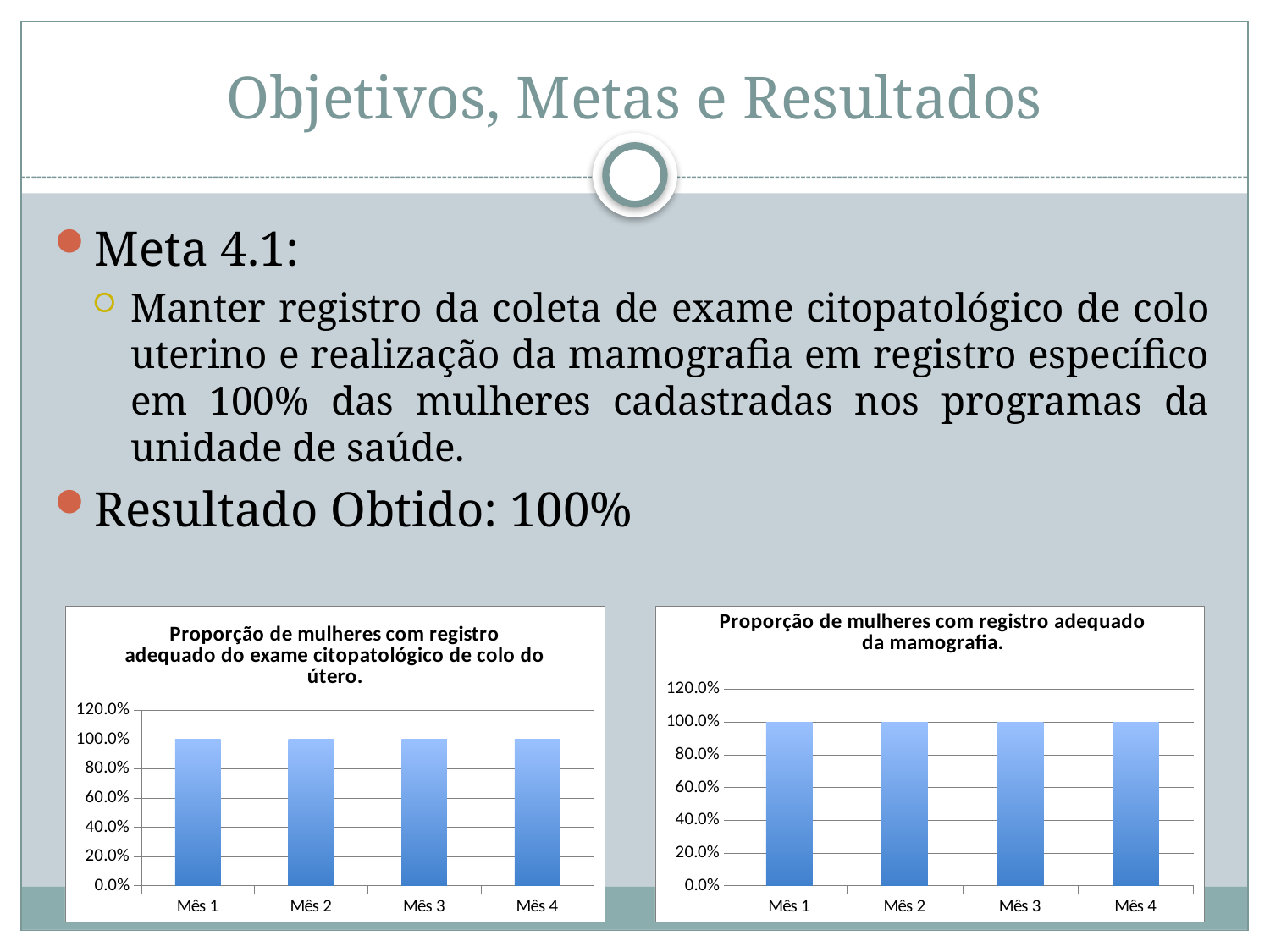
In the right chart (mamografia), do the values rise, fall or stay flat from Mês 1 to Mês 4? stay flat In the right chart (mamografia), what is the value for Mês 4? 100.0% In the right chart (mamografia), how many bars are plotted? 4 In the left chart (exame citopatológico), how many months are shown on the x axis? 4 In the left chart (exame citopatológico), what is the value for Mês 1? 100.0% What is the title of the right chart? Proporção de mulheres com registro adequado da mamografia. In the right chart (mamografia), is the value for Mês 2 greater or less than 120.0%? less What kind of chart is the left chart, 'Proporção de mulheres com registro adequado do exame citopatológico de colo do útero.'? bar chart In the left chart (exame citopatológico), is the value for Mês 3 greater or less than 80.0%? greater What kind of chart is the right chart, 'Proporção de mulheres com registro adequado da mamografia.'? bar chart In the left chart (exame citopatológico), what is the difference between the values for Mês 2 and Mês 4? 0.0% In the left chart (exame citopatológico), what is the highest value shown on the y axis? 120.0%